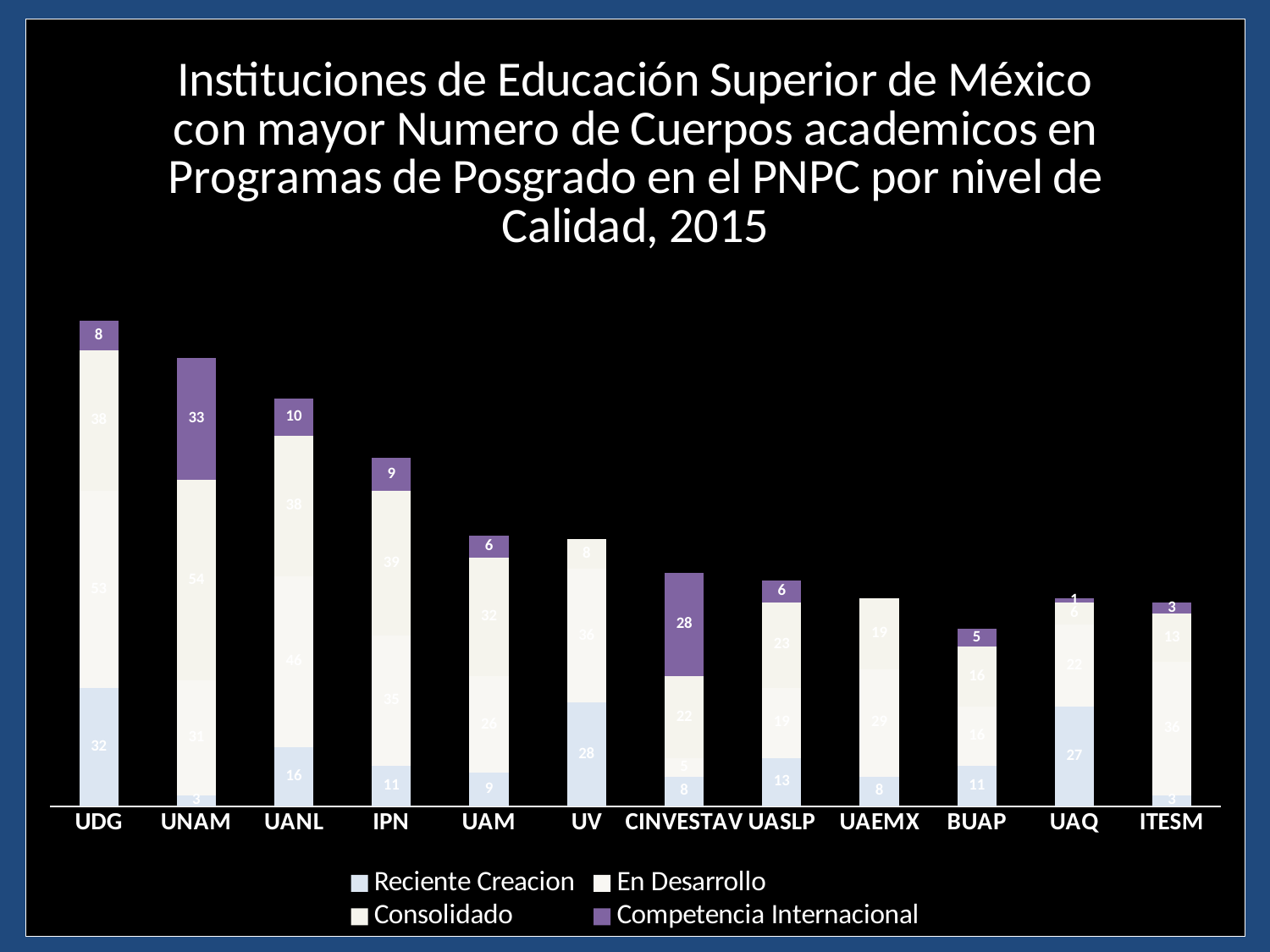
What is the difference between the Competencia Internacional values of UNAM and CINVESTAV? 5 Which institution has the highest Competencia Internacional value? UNAM What is the Competencia Internacional value for CINVESTAV? 28 What is the Competencia Internacional value for UNAM? 33 How many institutions are shown along the x axis? 12 What is the Reciente Creacion value for UAQ? 27 What is the Reciente Creacion value for UDG? 32 Which institution has the lowest non-zero Competencia Internacional value? UAQ Which is larger, the Reciente Creacion value for UV or for UASLP? UV What kind of chart is shown on the slide? Stacked bar chart How many series does the legend list? 4 Which institution has the tallest stacked bar overall? UDG